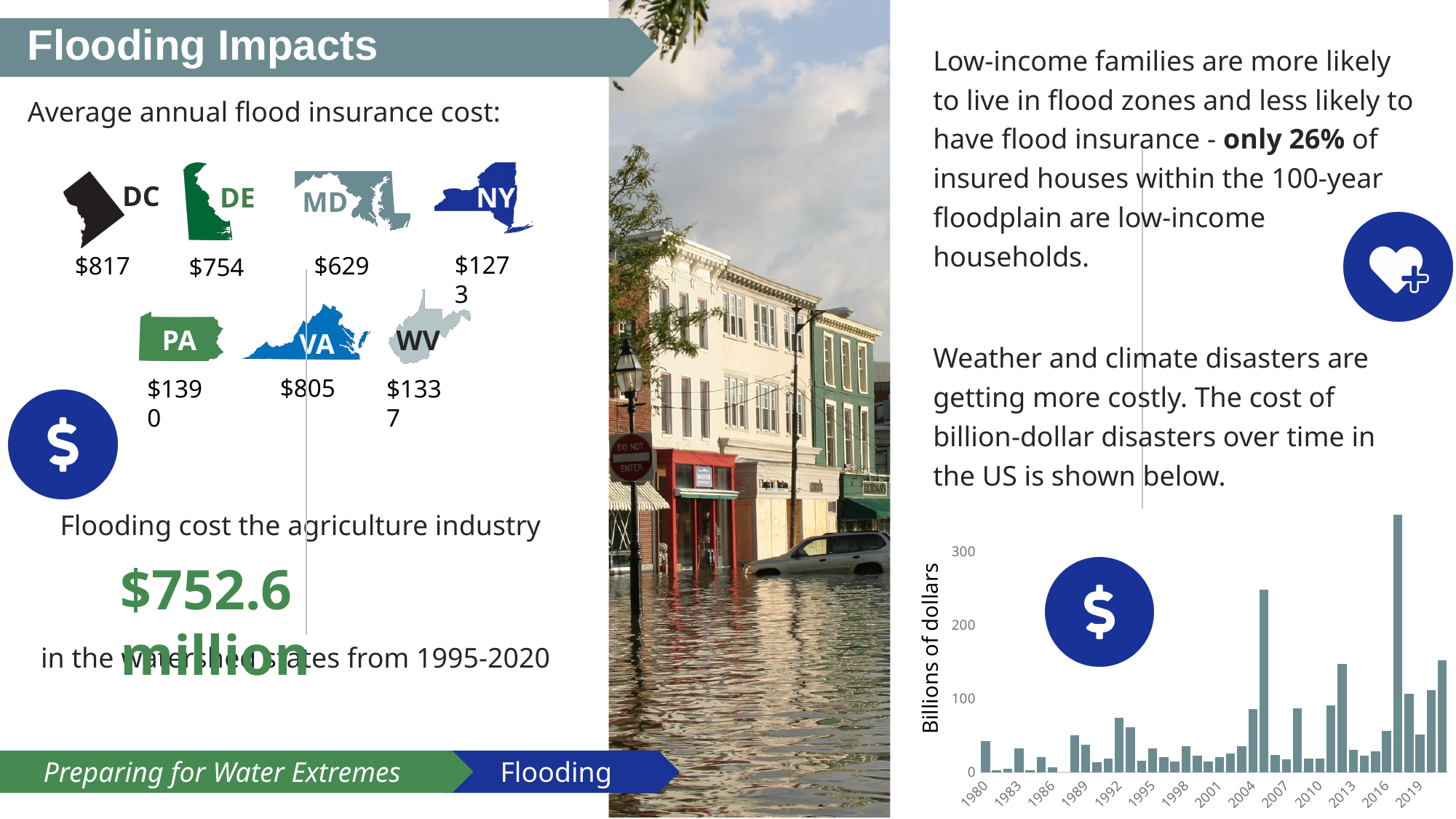
In the bar chart at the bottom right, do the values generally rise or fall from 1980 to the end of the series? rise In the bar chart at the bottom right, what is the last year labelled on the x axis? 2019 In the bar chart at the bottom right, how many year labels are shown on the x axis? 14 What kind of chart is shown at the bottom right of the slide? bar chart In the bar chart at the bottom right, what is the first year labelled on the x axis? 1980 In the bar chart at the bottom right, is the value for 1980 greater or less than 100? less In the bar chart at the bottom right, which has the larger value, 1989 or 1986? 1989 In the bar chart at the bottom right, is the value for 1992 greater or less than 100? less What is the y-axis title of the bar chart at the bottom right? Billions of dollars In the bar chart at the bottom right, is the value of the tallest bar greater or less than 300? greater In the bar chart at the bottom right, what is the highest value labelled on the y axis? 300 In the bar chart at the bottom right, which has the larger value, 1980 or 1983? 1980